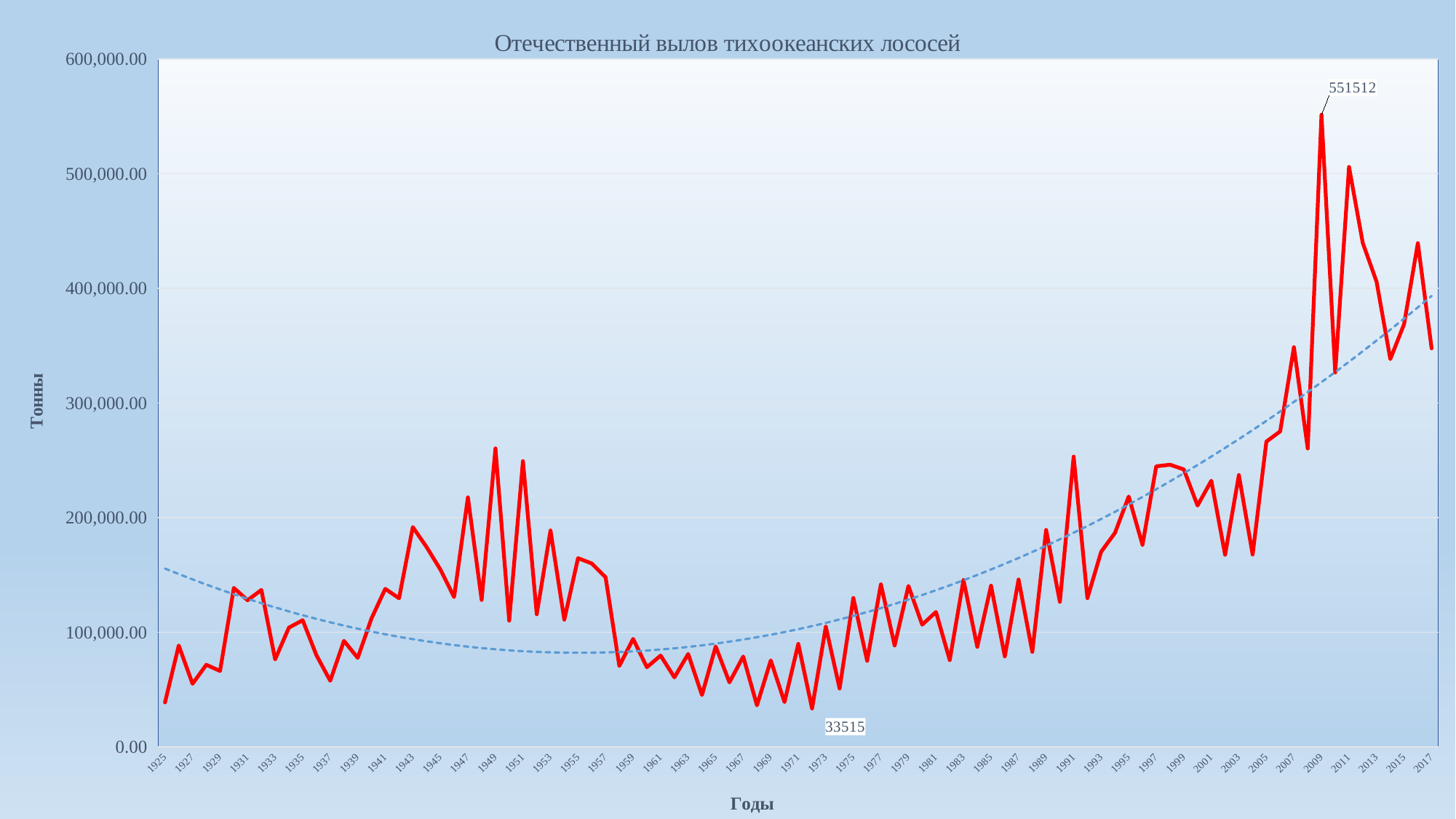
What is the label of the vertical axis? Тонны Which year has the larger value, 2009 or 2011? 2009 Is the value for 2017 greater or less than 300,000.00? greater In which year does the catch reach its peak of 551512 tonnes? 2009 Is the value for 2011 greater or less than 400,000.00? greater Is the value for 1925 greater or less than 100,000.00? less What is the title of the chart? Отечественный вылов тихоокеанских лососей What is the highest value labelled on the chart? 551512 What kind of chart is shown on the slide? line chart Does the catch generally rise or fall from 1990 to 2017? rise What is the lowest value labelled on the chart? 33515